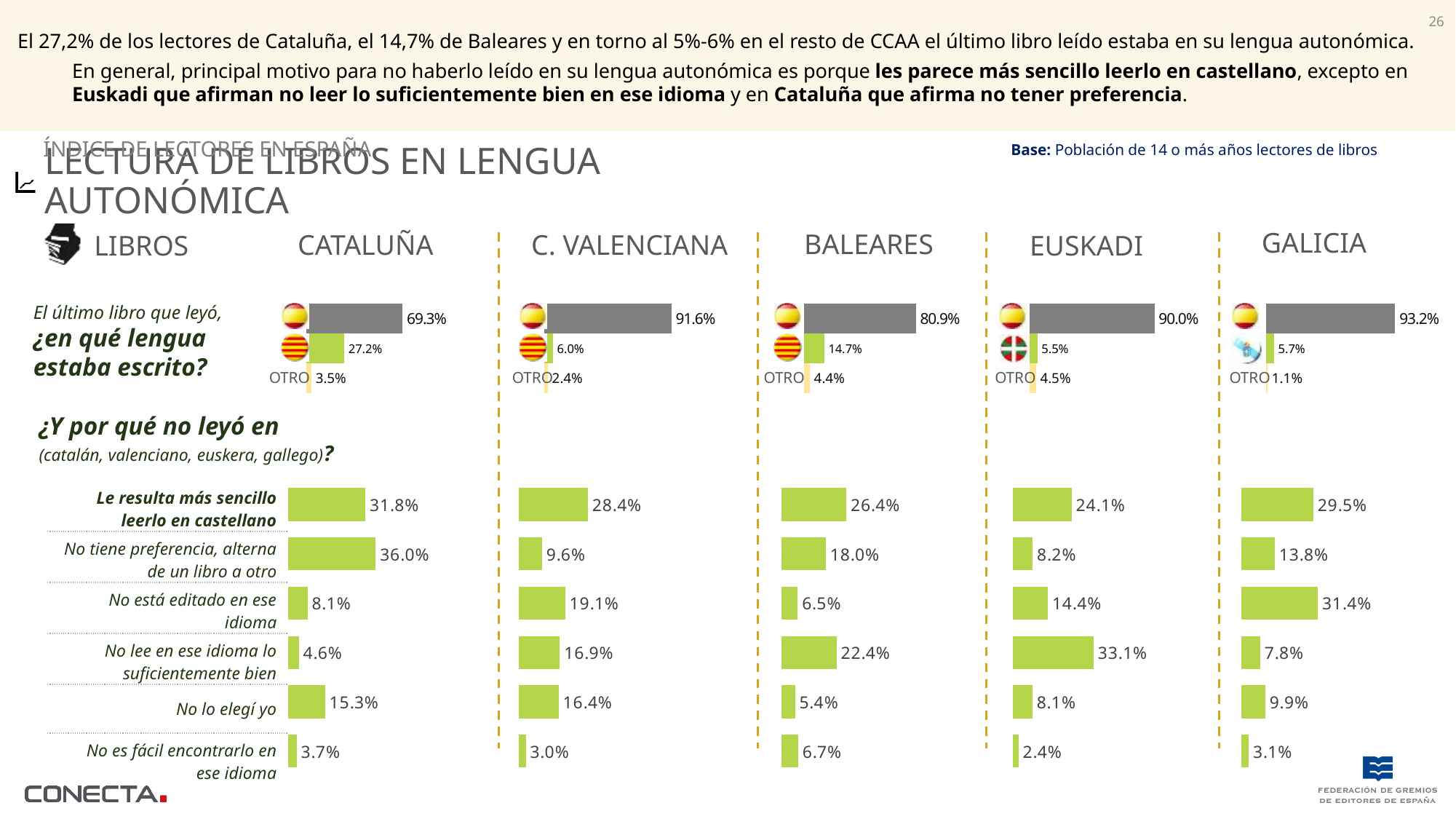
Which is larger: the 'No está editado en ese idioma' value for Galicia or for C. Valenciana? Galicia In the Baleares column, what is the 'OTRO' value for the language of the last book read? 4.4% What type of chart is used to show the reasons for not reading in the regional language? Bar chart How many regions (columns) are compared on the slide? 5 What is the difference between the 'Le resulta más sencillo leerlo en castellano' values for Cataluña and Euskadi? 7.7% In the Cataluña column, what percentage of readers said their last book was written in the regional language (the bar with the Catalan flag)? 27.2% How many reasons are listed in the '¿Y por qué no leyó en...?' section for each region? 6 In the Euskadi column, what is the value for 'No lee en ese idioma lo suficientemente bien'? 33.1% In the Galicia column, what percentage of readers said their last book was written in Spanish (the bar with the Spanish flag)? 93.2% In the Galicia column, which reason for not reading in the regional language has the lowest value? No es fácil encontrarlo en ese idioma Across the five regions, which region has the highest percentage of readers whose last book was in Spanish? Galicia In the Cataluña column, which reason for not reading in the regional language has the highest value? No tiene preferencia, alterna de un libro a otro